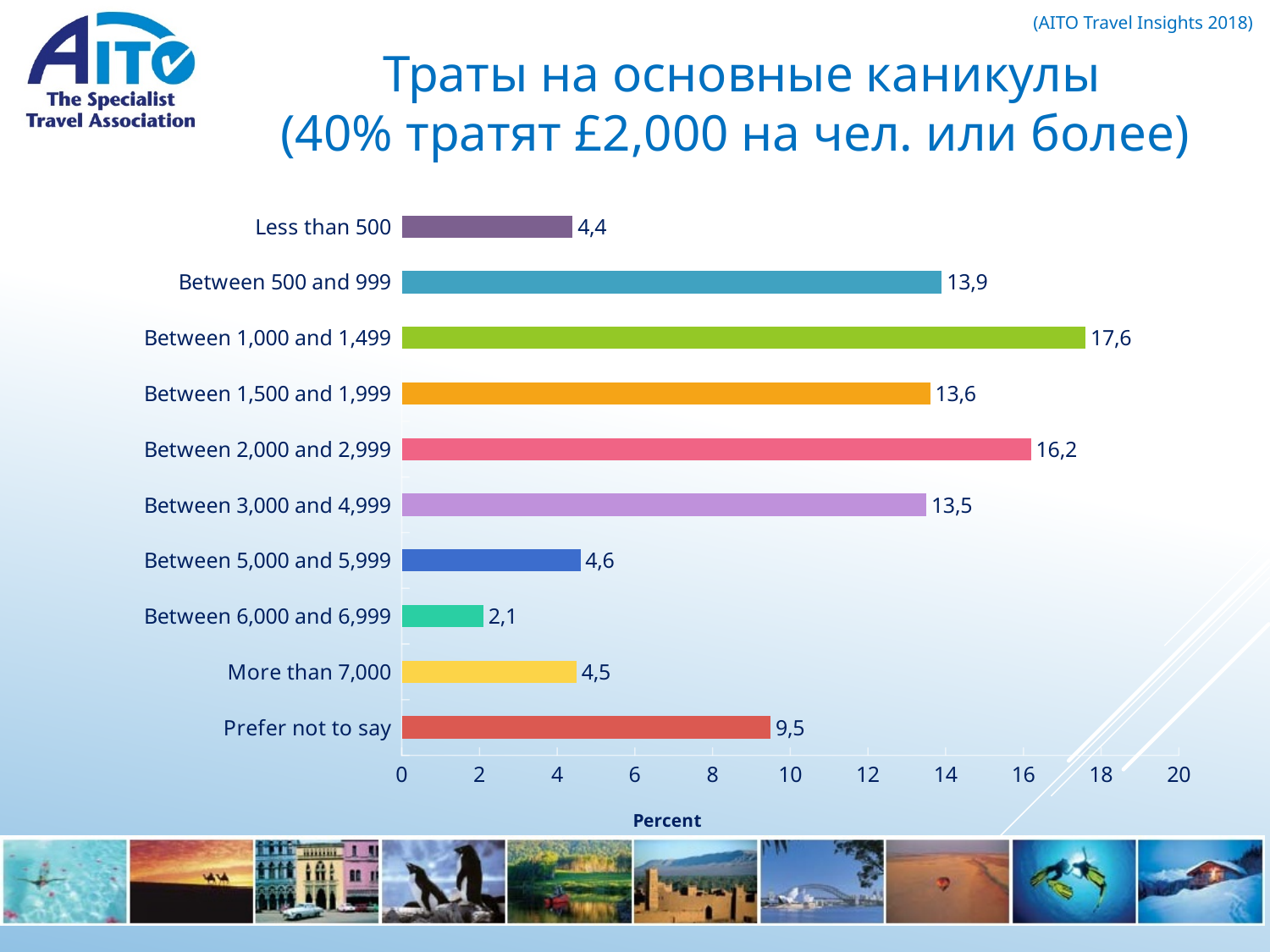
Is the value for Between 3,000 and 4,999 greater or less than 12? greater What is the difference between the values for Between 2,000 and 2,999 and Between 500 and 999? 2,3 What is the value for More than 7,000? 4,5 What is the label of the horizontal axis? Percent How many categories are shown in the chart? 10 Which category has the highest value? Between 1,000 and 1,499 What kind of chart is shown on the slide? bar chart What is the value for Prefer not to say? 9,5 Which is larger, the value for Less than 500 or the value for Between 5,000 and 5,999? Between 5,000 and 5,999 What is the difference between the values for Between 1,500 and 1,999 and Between 3,000 and 4,999? 0,1 What is the value for Between 1,000 and 1,499? 17,6 Which category has the lowest value? Between 6,000 and 6,999